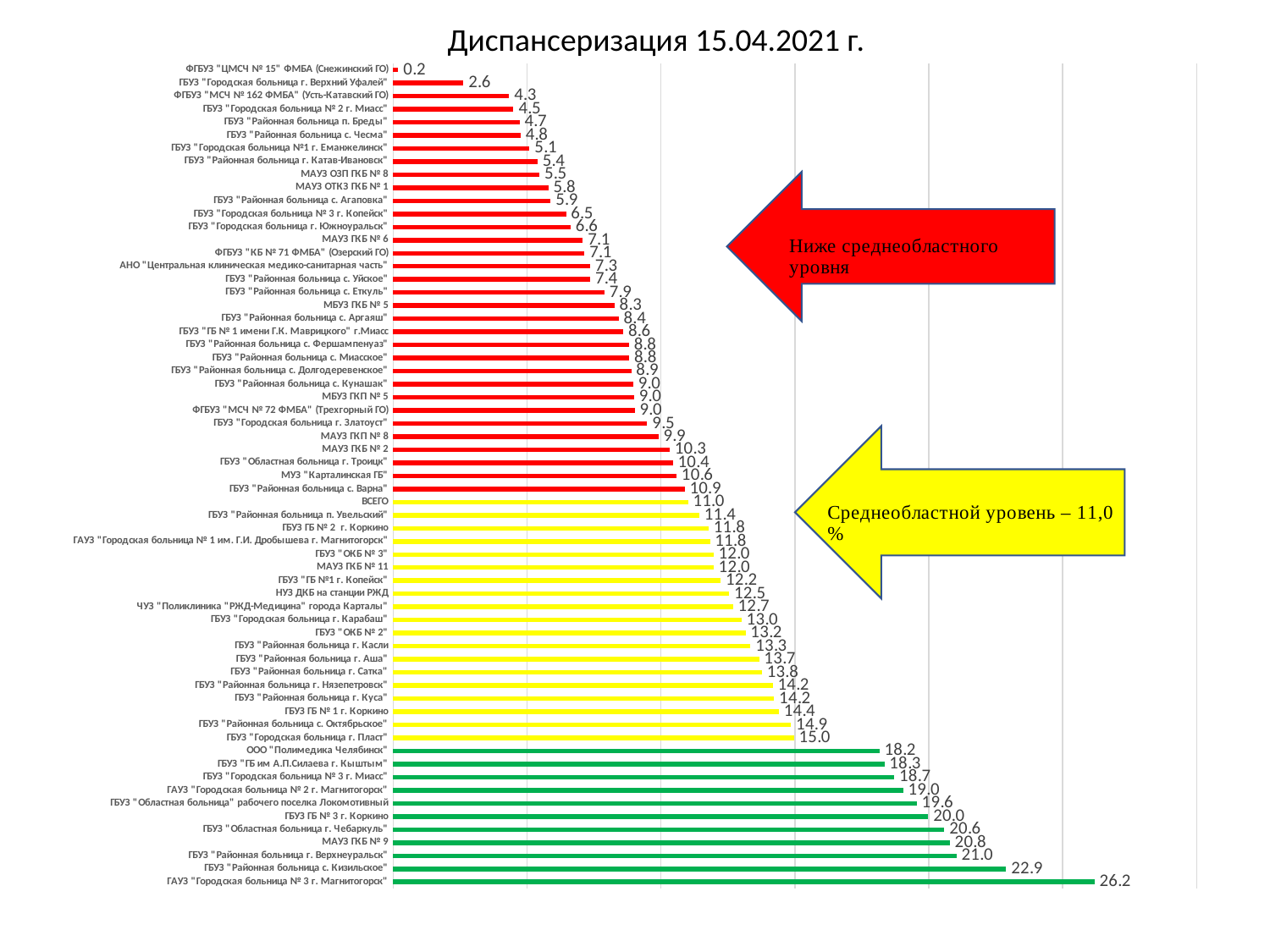
What is the value for ГАУЗ "Городская больница № 3 г. Магнитогорск"? 26.2 Which is larger, the value for ООО "Полимедика Челябинск" or the value for ГБУЗ "Городская больница г. Пласт"? ООО "Полимедика Челябинск" Which category has the lowest value? ФГБУЗ "ЦМСЧ № 15" ФМБА (Снежинский ГО) What is the value for ГБУЗ "Городская больница г. Пласт"? 15.0 What is the value for ГБУЗ "Районная больница с. Кизильское"? 22.9 What is the title of the chart? Диспансеризация 15.04.2021 г. What is the value for ВСЕГО? 11.0 Which category has the highest value? ГАУЗ "Городская больница № 3 г. Магнитогорск" According to the yellow arrow annotation, what is the regional average level (среднеобластной уровень)? 11,0 % What is the difference between the values for ГБУЗ "Городская больница г. Верхний Уфалей" and ФГБУЗ "ЦМСЧ № 15" ФМБА (Снежинский ГО)? 2.4 What is the difference between the values for ГАУЗ "Городская больница № 3 г. Магнитогорск" and ГБУЗ "Районная больница с. Кизильское"? 3.3 What kind of chart is shown on the slide? Bar chart